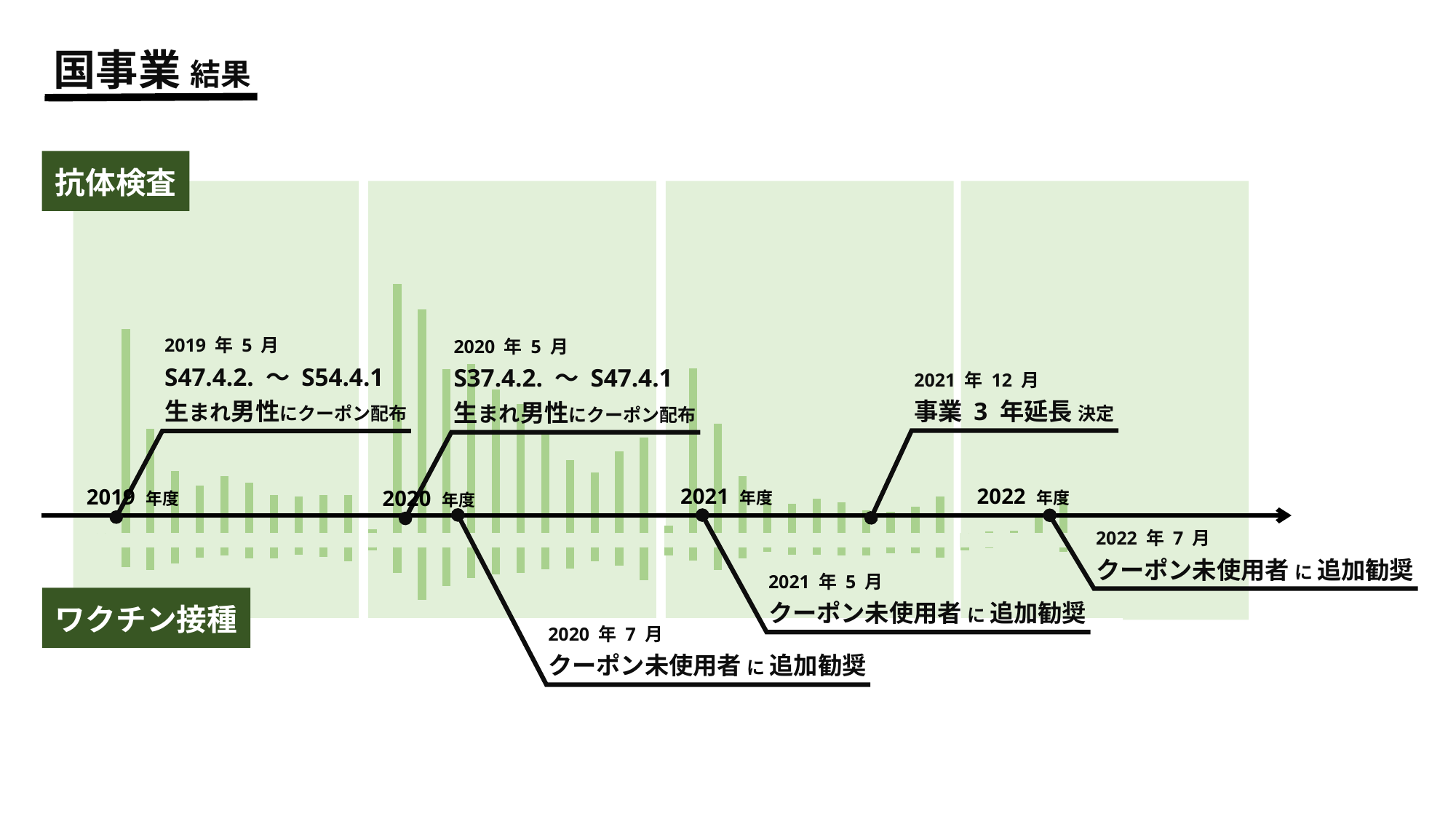
Which series is plotted above the timeline axis? 抗体検査 Which fiscal year contains the tallest 抗体検査 (antibody test) bar, 2019年度 or 2020年度? 2020年度 Are the 抗体検査 bars in 2022年度 taller or shorter than those at the start of 2020年度? Shorter Which birth-date range of men received coupons in 2020年5月? S37.4.2.～S47.4.1 Which series is plotted below the timeline axis? ワクチン接種 How many fiscal years (年度) are labelled along the timeline axis? 4 What kind of chart is shown on the timeline? Bar chart What event is marked at 2021年12月 on the timeline? 事業3年延長決定 What is the title of the slide? 国事業 結果 How many dated events are marked on the timeline? 6 Which birth-date range of men received coupons in 2019年5月? S47.4.2.～S54.4.1